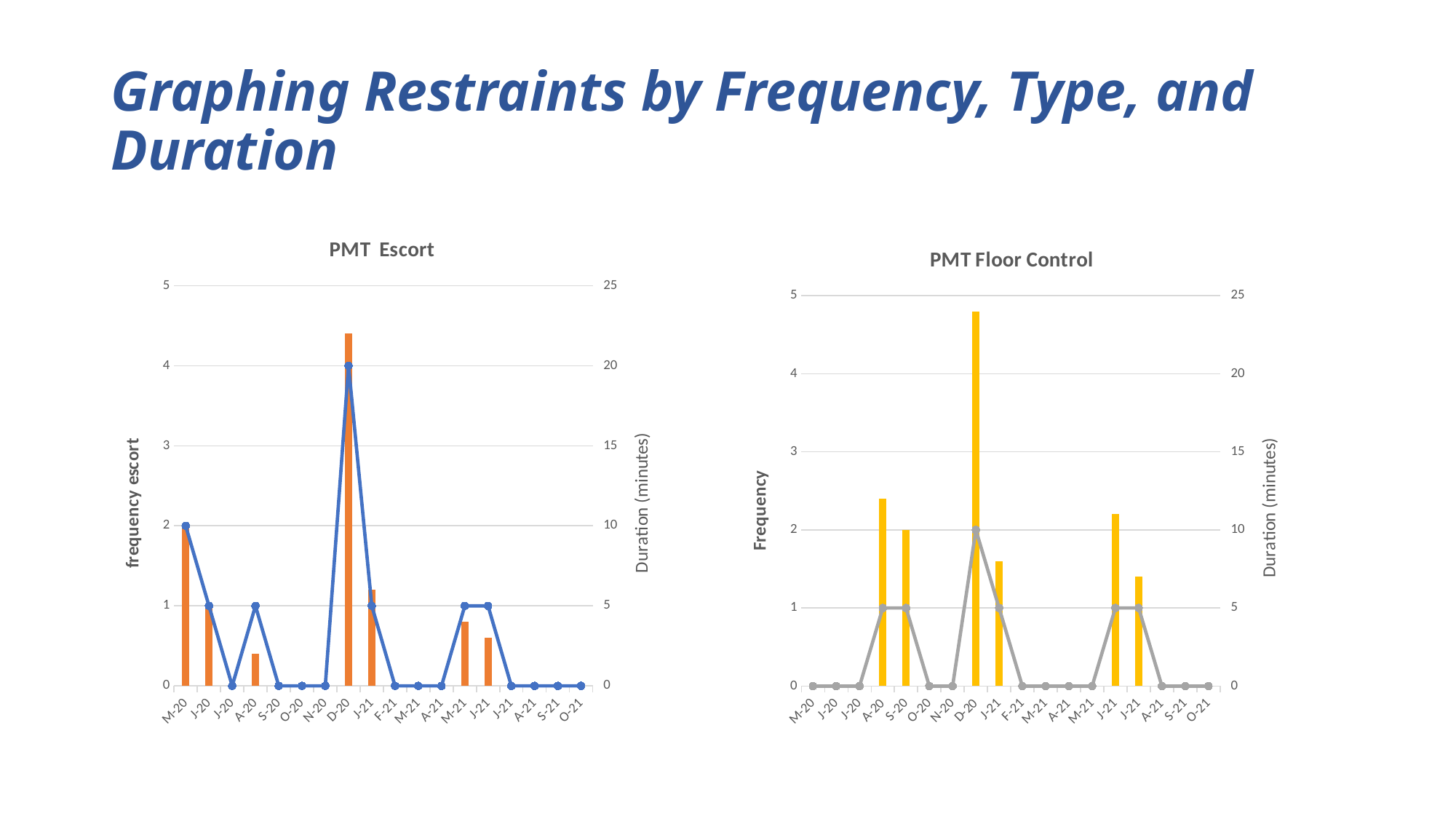
In the PMT Escort chart, which month has the highest frequency? D-20 In the PMT Floor Control chart, is the duration bar for D-20 greater or less than 20 minutes? greater In the PMT Floor Control chart, what is the frequency value for D-20? 2 In the PMT Floor Control chart, which month has the tallest duration bar? D-20 In the PMT Floor Control chart, what is the duration in minutes for S-20? 10 In the PMT Escort chart, what is the difference between the frequency at D-20 and the frequency at M-20? 2 In the PMT Escort chart, what is the frequency value for D-20? 4 In the PMT Escort chart, is the duration bar for D-20 greater or less than 20 minutes? greater How many months are shown on the x axis of the PMT Escort chart? 18 What is the label of the right-hand vertical axis on the PMT Floor Control chart? Duration (minutes) In the PMT Floor Control chart, what is the frequency value for A-20? 1 In the PMT Escort chart, what is the frequency value for M-20? 2